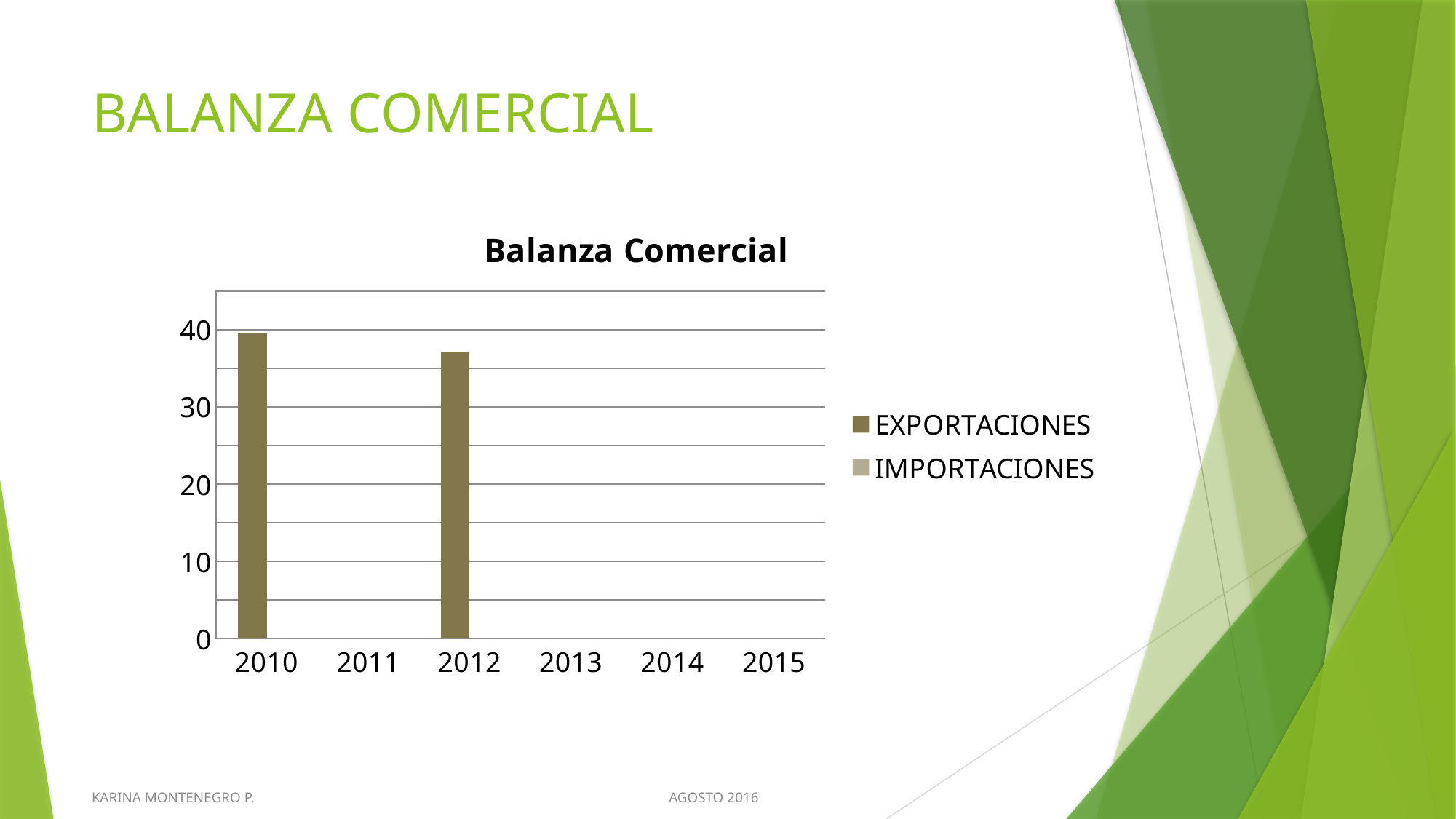
Do the EXPORTACIONES bars rise or fall from 2010 to 2012? fall Is the EXPORTACIONES value for 2012 greater or less than 30? greater Which year has the higher EXPORTACIONES bar, 2010 or 2012? 2010 How many series does the chart legend list? 2 What is the title of the chart? Balanza Comercial What kind of chart is shown on the slide? Bar chart Is the EXPORTACIONES value for 2010 greater or less than 30? greater Is the EXPORTACIONES value for 2012 greater or less than 40? less Which year has the tallest bar in the chart? 2010 How many years are shown on the x axis of the chart? 6 For which years are EXPORTACIONES bars plotted in the chart? 2010 and 2012 Which two series are listed in the chart legend? EXPORTACIONES and IMPORTACIONES